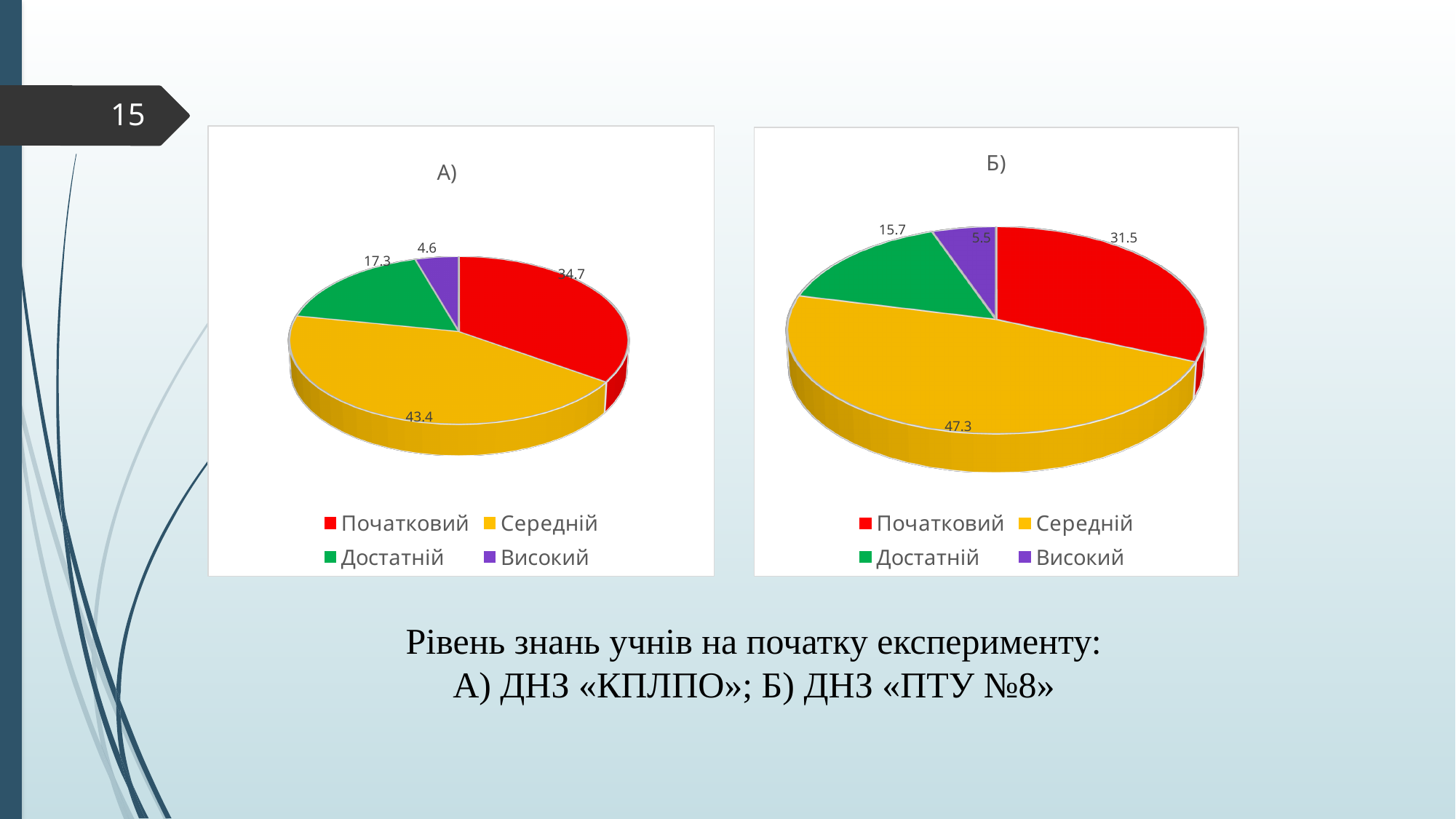
In chart А), what is the value for Середній? 43.4 In chart Б), what is the value for Початковий? 31.5 In chart А), what is the value for Достатній? 17.3 In chart Б), what is the value for Високий? 5.5 In chart А), what is the difference between Достатній and Високий? 12.7 Which is larger: Початковий in chart А) or Початковий in chart Б)? Початковий in chart А) How many slices does chart Б) have? 4 In chart Б), which category has the smallest slice? Високий In chart Б), what is the difference between Середній and Початковий? 15.8 What type of chart is chart А)? Pie chart In chart А), which category has the largest slice? Середній In chart А), what colour is the Достатній slice? Green